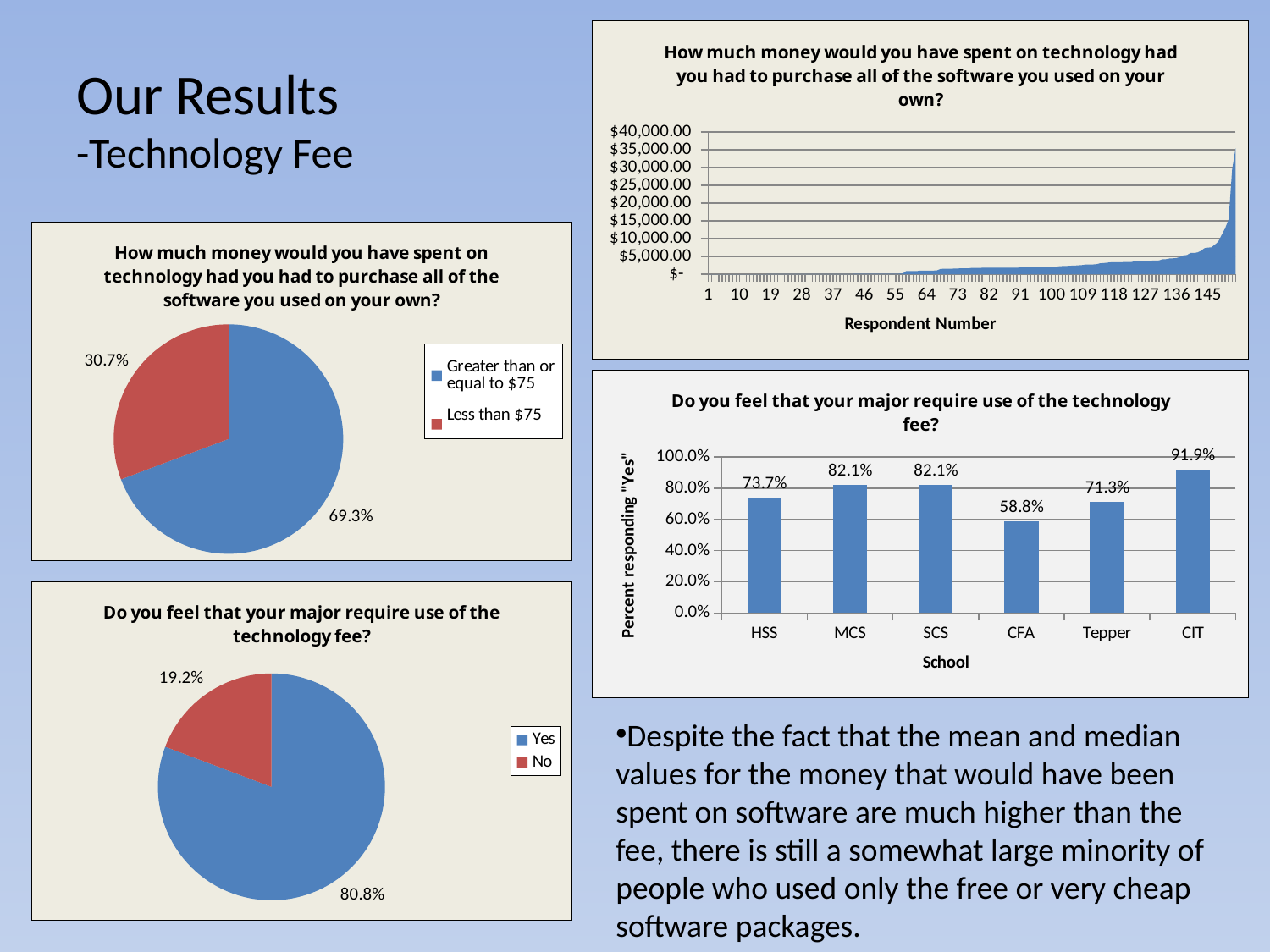
In the bottom-left pie chart, how many slices are there? 2 In the bottom-right bar chart by school, what is the difference between the CIT value and the CFA value? 33.1% In the bottom-right bar chart by school, how many schools are shown on the x axis? 6 In the top-left pie chart about money spent on technology, what share of respondents would have spent less than $75? 30.7% In the bottom-right bar chart by school, is the value for HSS greater or less than 80.0%? less In the top-left pie chart about money spent on technology, what share of respondents would have spent greater than or equal to $75? 69.3% In the bottom-right bar chart by school, which school has the highest percent responding Yes? CIT In the bottom-left pie chart about whether the major requires the technology fee, what percentage answered No? 19.2% In the bottom-right bar chart by school, what is the percent responding Yes for Tepper? 71.3% In the bottom-left pie chart about whether the major requires the technology fee, what percentage answered Yes? 80.8% In the bottom-right bar chart by school, which school has the lowest percent responding Yes? CFA In the top-right chart by respondent number, do the values rise or fall as the respondent number increases? rise